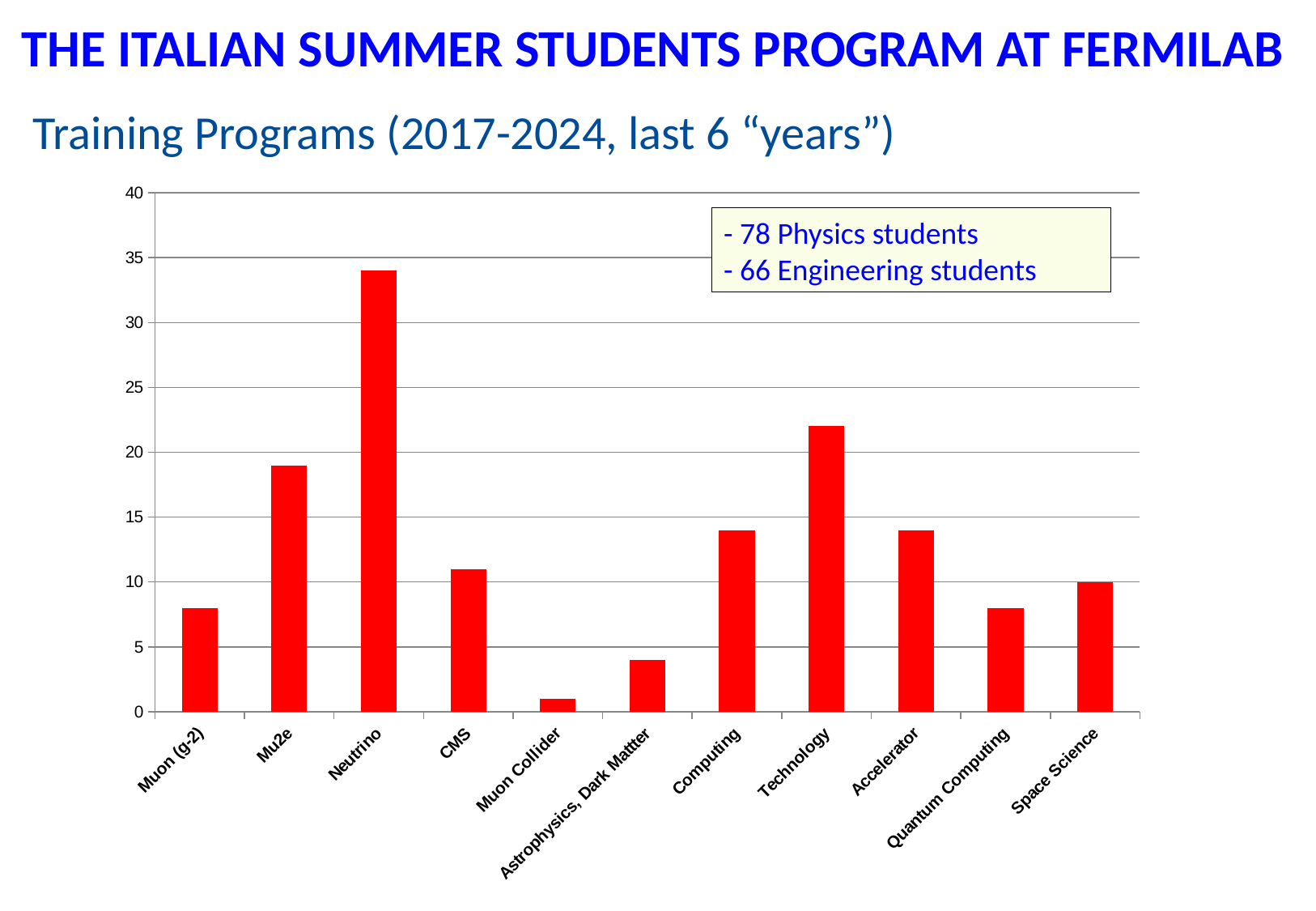
Is the value for Mu2e greater or less than 20? less What kind of chart is shown on the slide? bar chart Is the value for Astrophysics, Dark Matter greater or less than 5? less Which training program has the highest bar in the chart? Neutrino Which has a larger value, Technology or Mu2e? Technology Which training program has the lowest bar in the chart? Muon Collider Is the value for CMS greater or less than 10? greater What colour are the bars in the chart? red How many training program categories are shown on the x axis of the chart? 11 Which has a larger value, Muon (g-2) or Computing? Computing